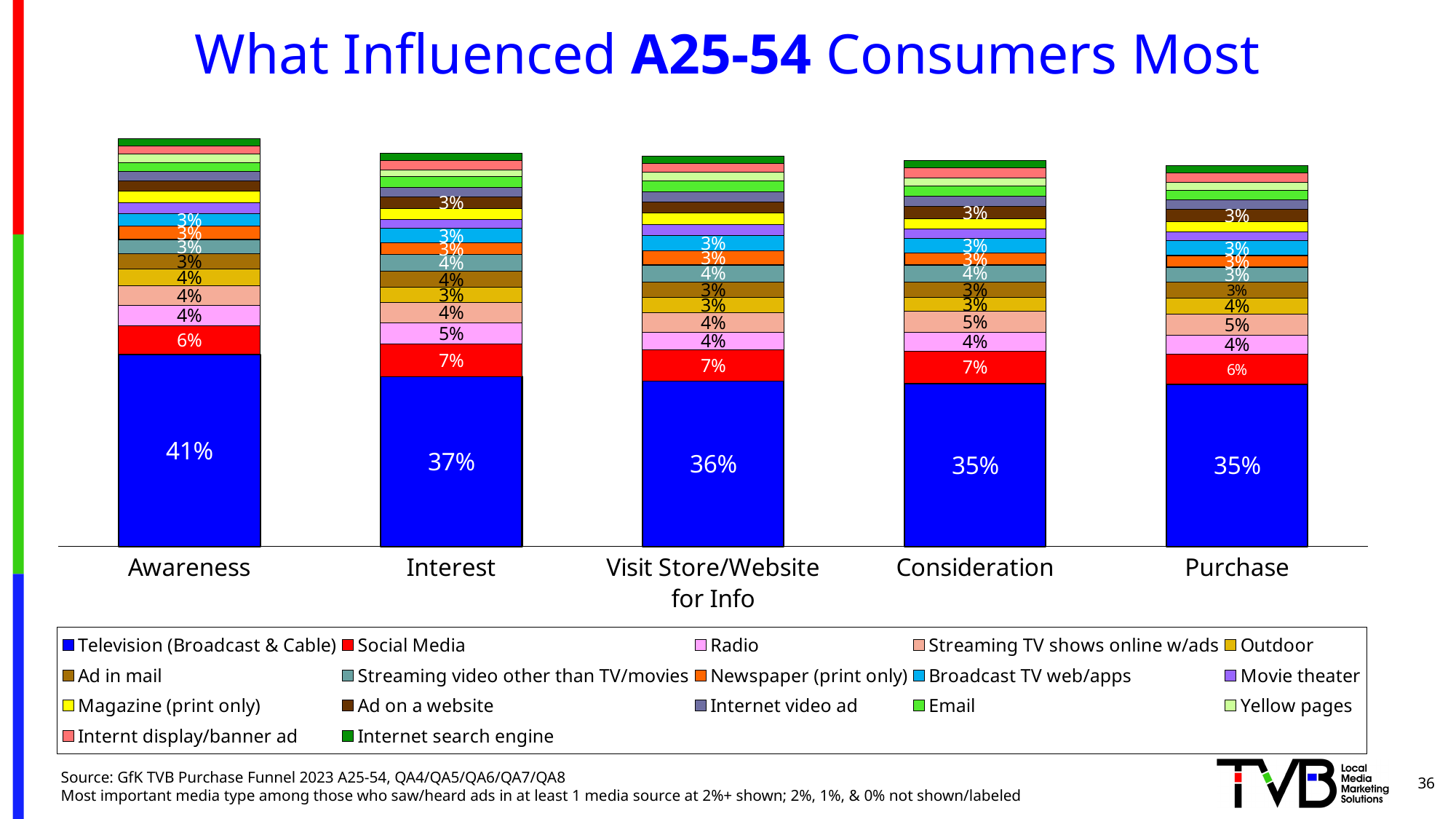
How many stages are shown along the x axis? 5 Does the Television (Broadcast & Cable) value rise or fall from Awareness to Purchase? Fall What is the Television (Broadcast & Cable) value for Visit Store/Website for Info? 36% What is the Radio value for the Interest stage? 5% How many series does the legend list? 17 What kind of chart is shown on the slide? Stacked bar chart What is the Television (Broadcast & Cable) value for the Awareness stage? 41% What is the difference between the Television (Broadcast & Cable) values for Awareness and Interest? 4 percentage points Which stage has the highest Television (Broadcast & Cable) value? Awareness What is the Social Media value for the Interest stage? 7% What is the Television (Broadcast & Cable) value for the Purchase stage? 35% Which stage has the larger Social Media value, Awareness or Interest? Interest